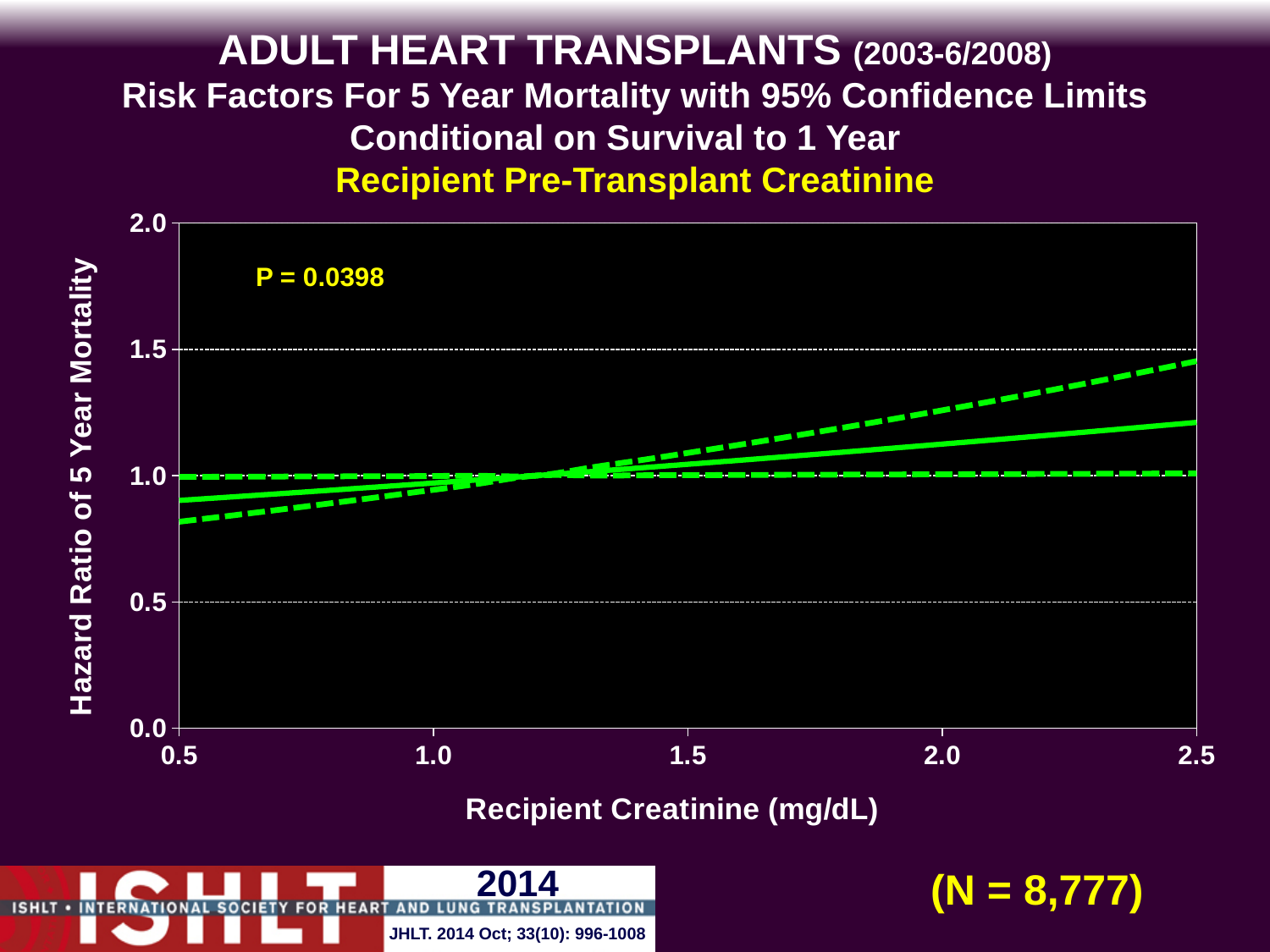
How many dashed confidence limit lines are plotted on the chart? 2 Is the hazard ratio (solid line) at a recipient creatinine of 0.5 mg/dL greater or less than 1.0? less Is the hazard ratio (solid line) at a recipient creatinine of 2.0 mg/dL greater or less than 1.0? greater Is the upper confidence limit (upper dashed line) at a recipient creatinine of 2.5 mg/dL greater or less than 1.0? greater Does the solid hazard ratio line rise or fall as recipient creatinine increases from 0.5 to 2.5 mg/dL? rise Which is larger: the hazard ratio (solid line) at a recipient creatinine of 2.5 mg/dL or at 0.5 mg/dL? 2.5 mg/dL How many tick labels are shown on the x axis? 5 What sample size (N) is shown on the slide? N = 8,777 What P value is printed on the chart? P = 0.0398 What kind of chart is shown on the slide? line chart